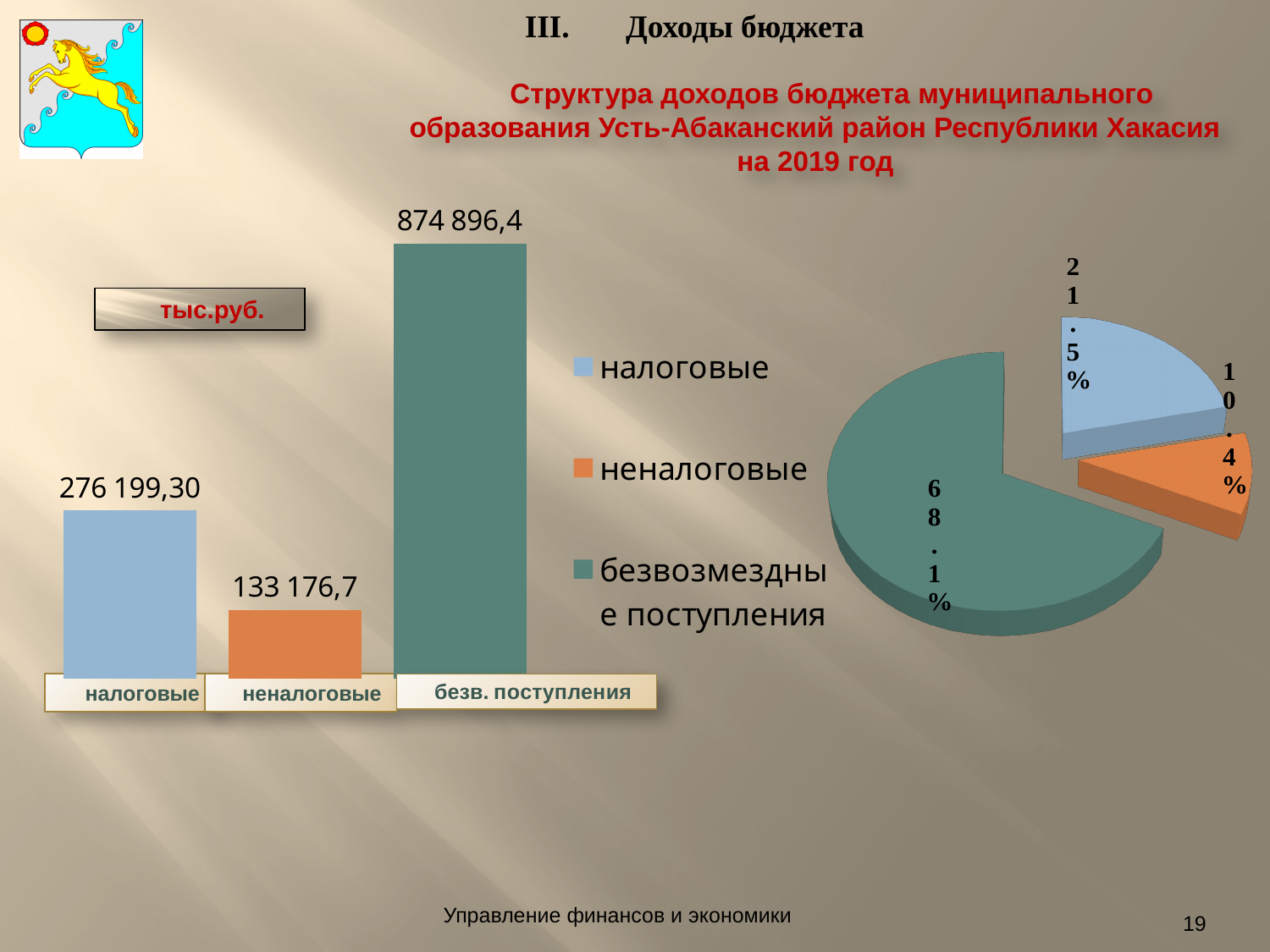
In the bar chart on the left, which category has the highest value? безв. поступления In the bar chart on the left, what is the difference between безв. поступления and налоговые? 598 697,1 In the pie chart on the right, what share does the безвозмездные поступления slice have? 68.1% In the bar chart on the left, what is the value for налоговые? 276 199,30 In the bar chart on the left, which is larger: налоговые or неналоговые? налоговые In the bar chart on the left, what is the value for неналоговые? 133 176,7 What kind of chart is the chart on the left of the slide? bar chart In the bar chart on the left, what is the value for безв. поступления? 874 896,4 In the bar chart on the left, which category has the lowest value? неналоговые How many entries does the legend between the two charts list? 3 In the bar chart on the left, how many categories are shown? 3 In the pie chart on the right, what share does the налоговые slice have? 21.5%